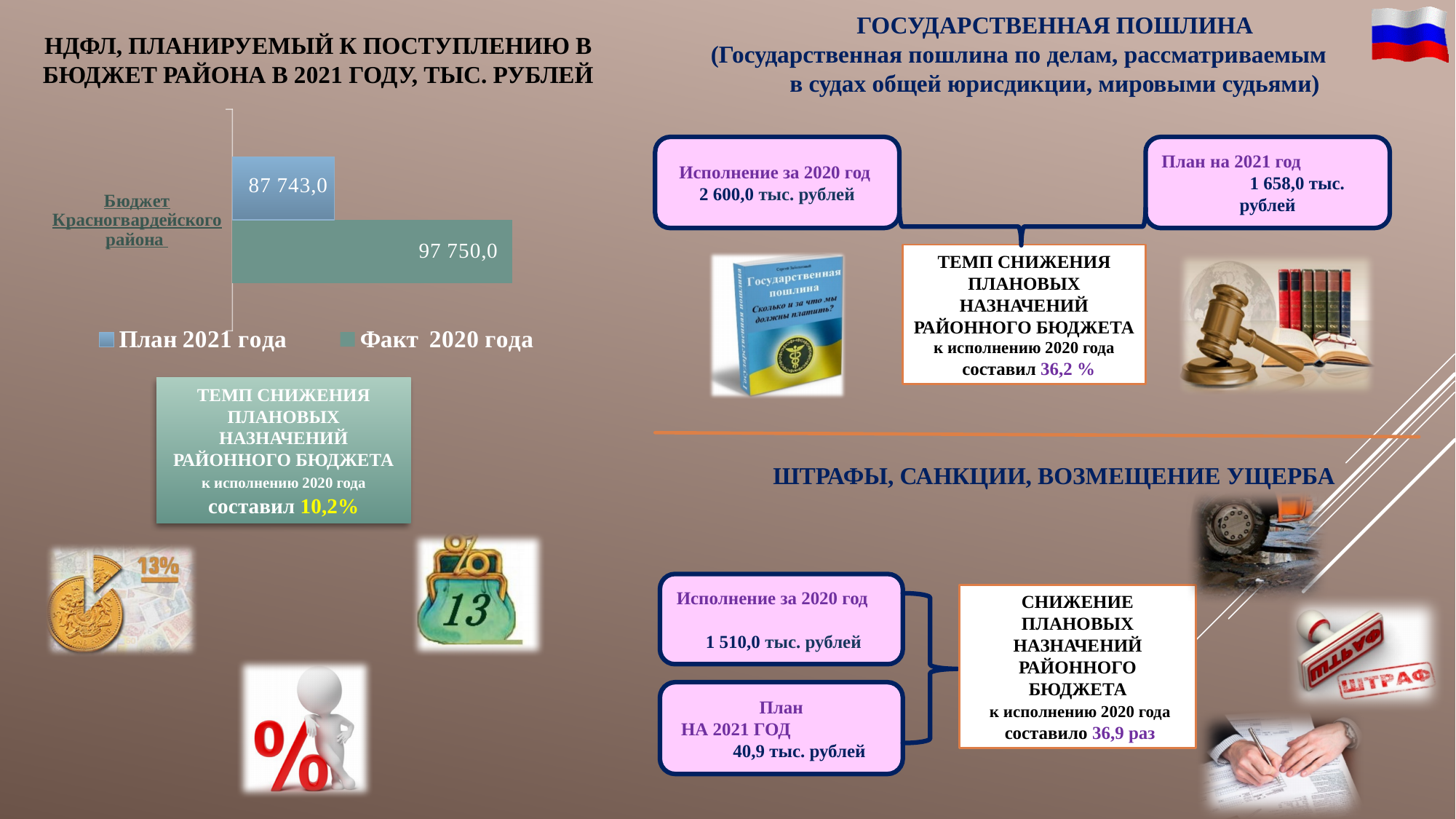
What is the value of the 'Факт 2020 года' bar in the chart? 97 750,0 Which series shows the highest value in the chart? Факт 2020 года In what units are the values in the chart expressed, according to its title? тыс. рублей Which series has the larger value in the chart, 'План 2021 года' or 'Факт 2020 года'? Факт 2020 года What type of chart is shown on the slide? Bar chart What is the category label shown on the chart's axis? Бюджет Красногвардейского района What is the difference between the 'Факт 2020 года' value and the 'План 2021 года' value in the chart? 10 007,0 What is the value of the 'План 2021 года' bar in the chart? 87 743,0 How many series does the chart legend list? 2 How many categories are plotted on the chart's category axis? 1 Which series shows the lowest value in the chart? План 2021 года